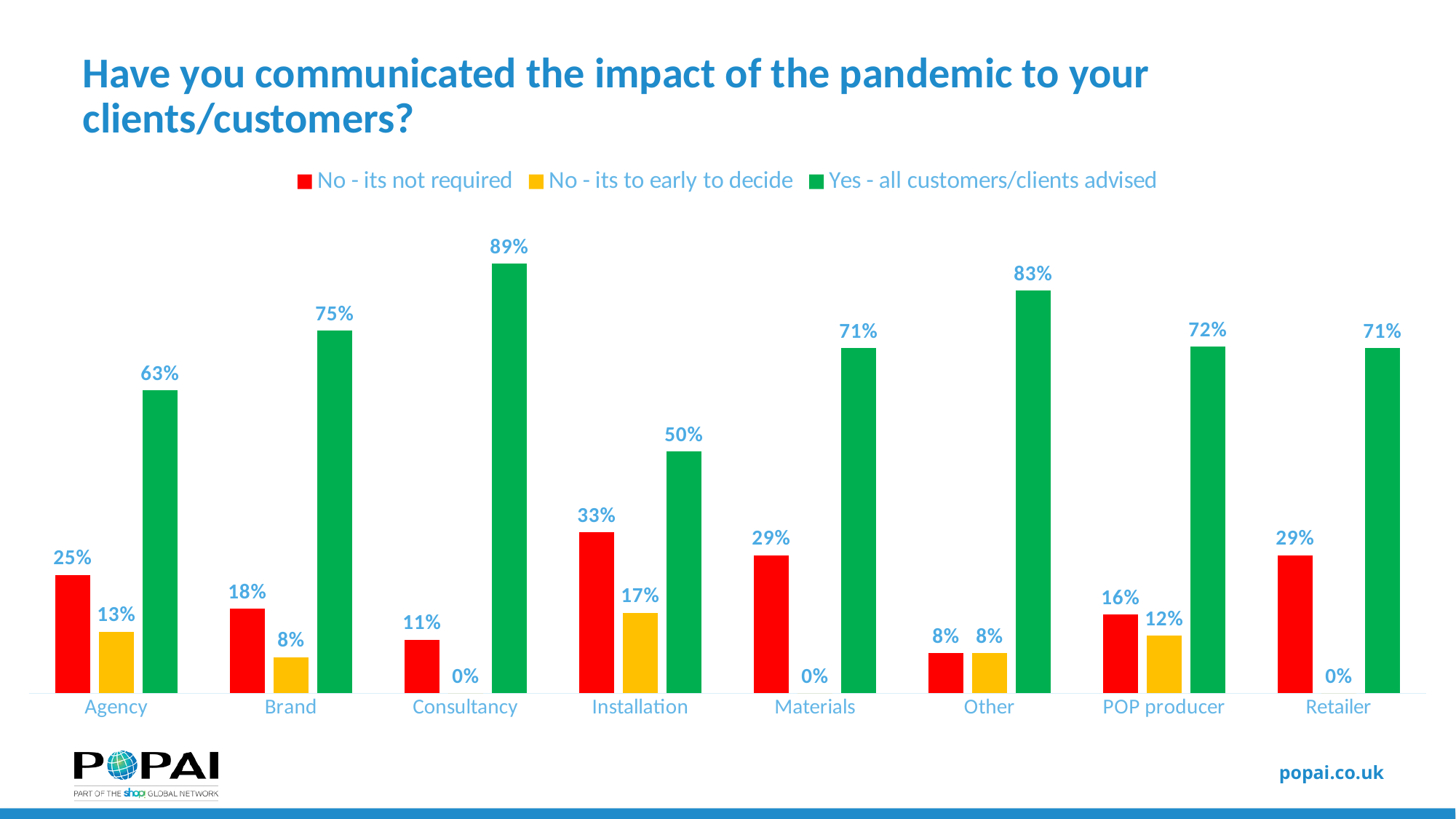
What is the difference between the 'Yes - all customers/clients advised' values for Other and Agency? 20% What colour represents the 'Yes - all customers/clients advised' series? Green What kind of chart is shown on the slide? Bar chart How many series does the legend list? 3 Which category has the lowest value for 'Yes - all customers/clients advised'? Installation What percentage of Consultancy respondents answered 'Yes - all customers/clients advised'? 89% Which categories have a value of 0% for 'No - its to early to decide'? Consultancy, Materials, Retailer Which category has the highest value for 'Yes - all customers/clients advised'? Consultancy Which is larger: the 'No - its not required' value for Installation or for Materials? Installation What is the value for 'No - its not required' for POP producer? 16% What is the value for 'No - its to early to decide' for Installation? 17% How many categories are shown on the x axis? 8